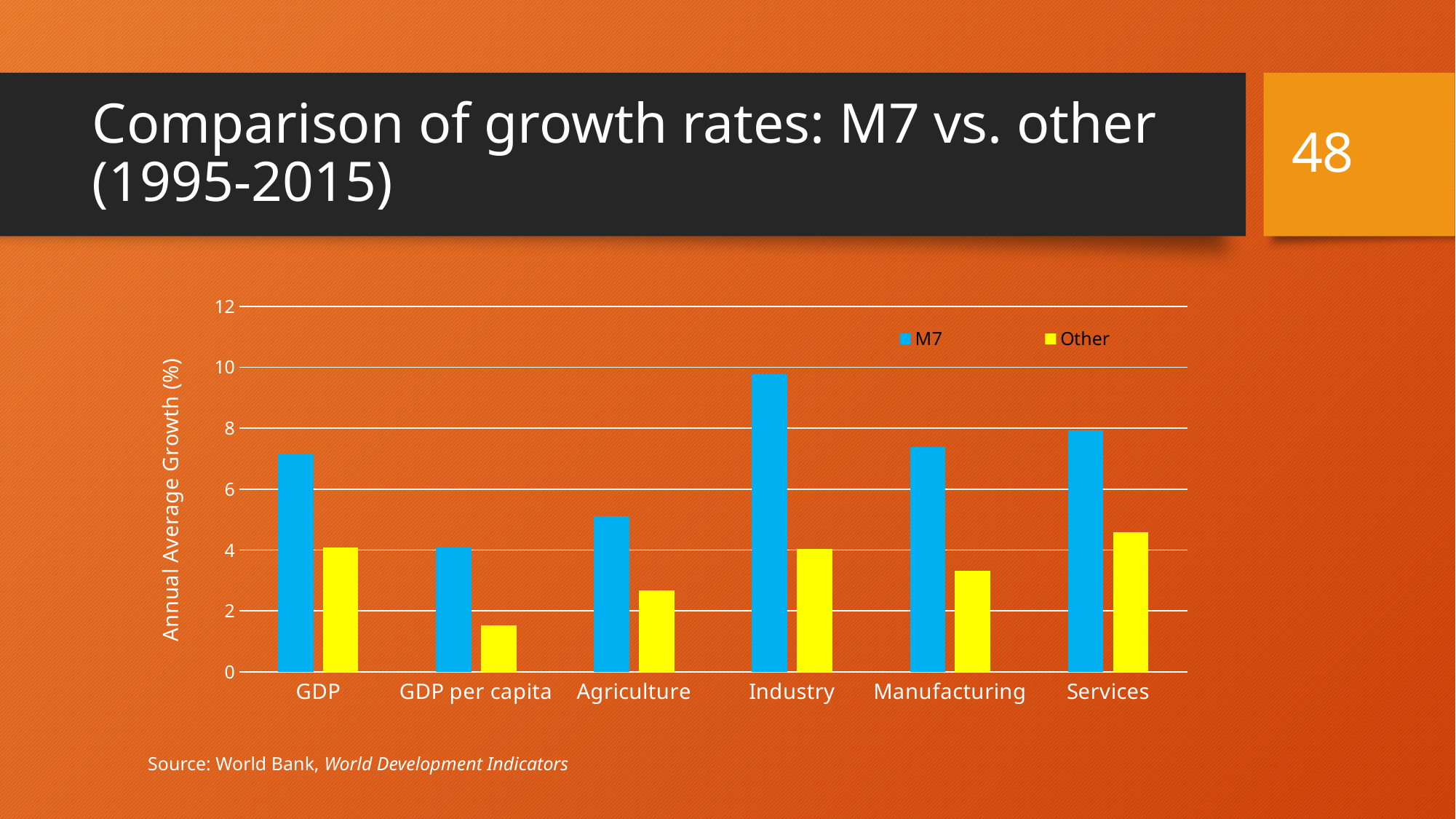
How many series does the legend list? 2 For Industry, which series has the larger value, M7 or Other? M7 Which category has the highest M7 growth rate? Industry What is the label on the vertical axis? Annual Average Growth (%) Is the M7 value for Agriculture greater or less than 6? less Which is larger for the M7 series: Services or Manufacturing? Services Which category has the lowest growth rate for the Other series? GDP per capita What kind of chart is shown on the slide? bar chart Is the M7 value for Industry greater or less than 8? greater How many categories are shown on the x axis? 6 Is the Other value for GDP per capita greater or less than 2? less Which category has the lowest M7 growth rate? GDP per capita